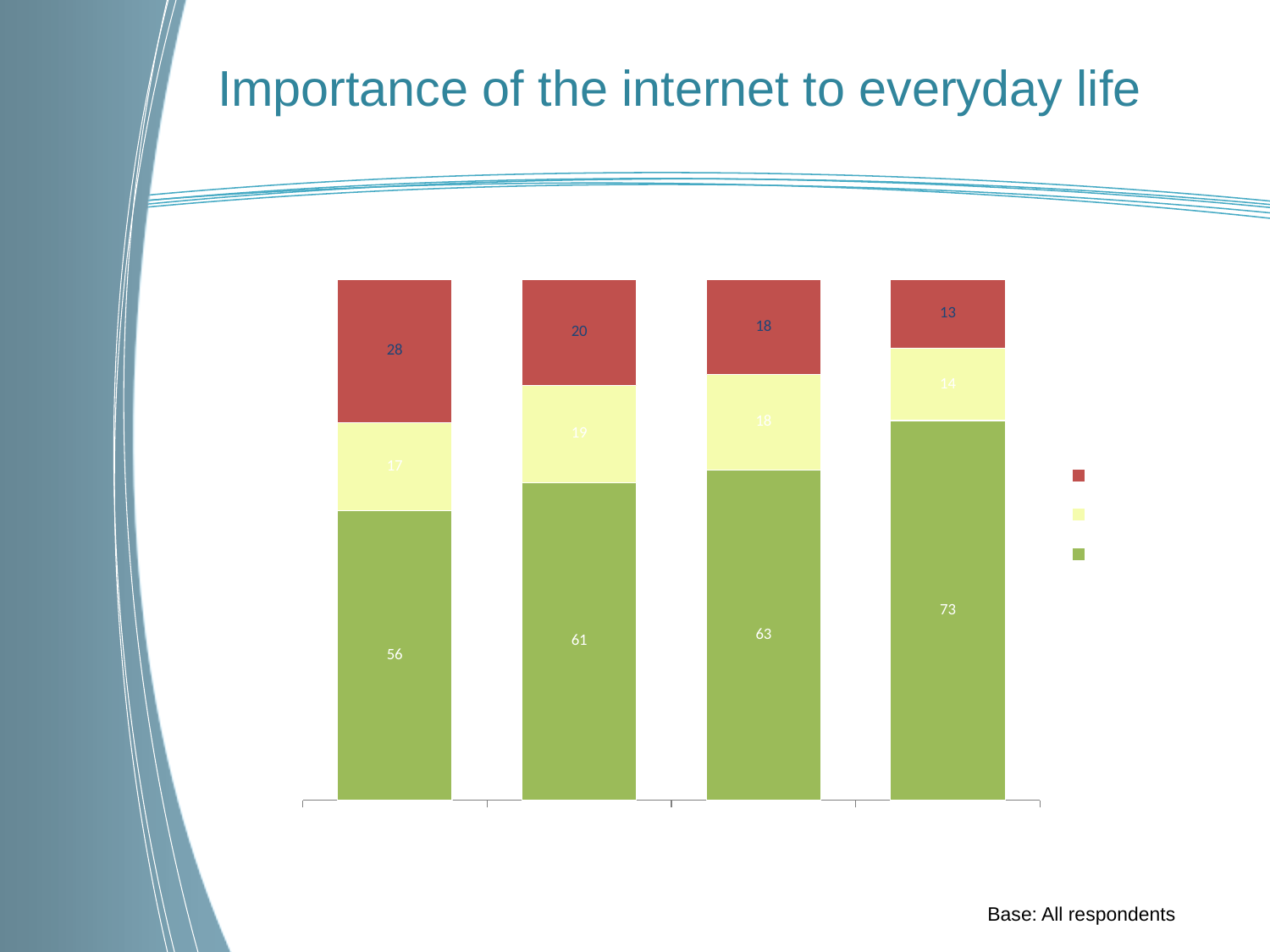
Which bar has the smallest red segment? The fourth (rightmost) bar Which is larger, the red segment of the first bar or the red segment of the second bar? The red segment of the first bar How many series does the chart's legend list? 3 What is the value of the green segment in the first (leftmost) bar? 56 What is the value of the red segment in the fourth (rightmost) bar? 13 Which bar has the largest green segment? The fourth (rightmost) bar What is the difference between the green segment of the fourth bar and the green segment of the first bar? 17 What is the value of the yellow segment in the second bar from the left? 19 Do the green segment values rise or fall from left to right across the bars? Rise What kind of chart is shown on the slide? Stacked bar chart What is the total of the second bar from the left? 100 How many bars are plotted in the chart? 4